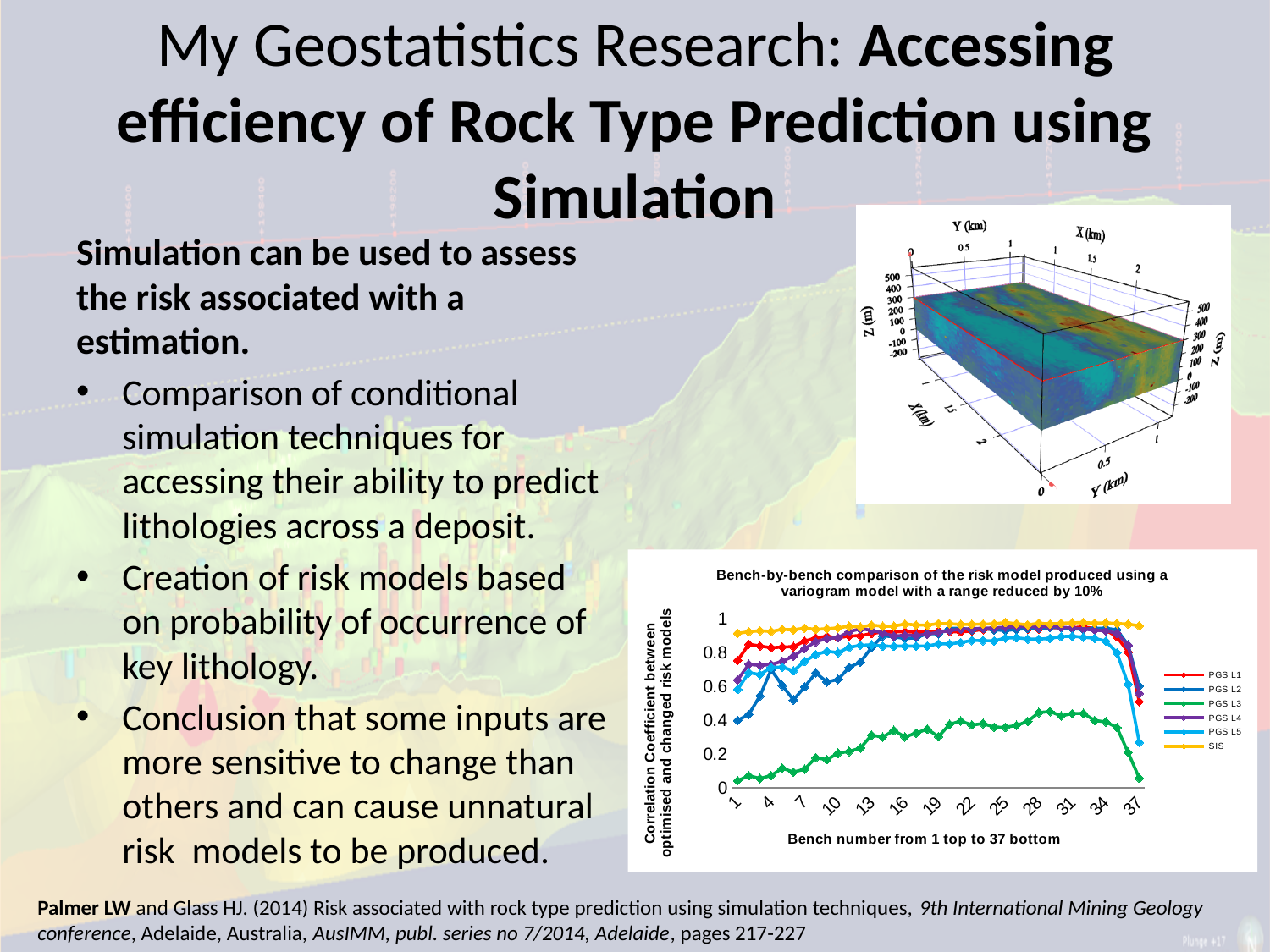
In the 'Bench-by-bench comparison' chart, is the value for PGS L3 at bench 37 greater or less than 0.2? less In the 'Bench-by-bench comparison' chart, is the value for PGS L2 at bench 1 greater or less than 0.6? less In the 'Bench-by-bench comparison' chart, is the value for SIS at bench 1 greater or less than 0.8? greater What kind of chart is the 'Bench-by-bench comparison' chart on the slide? line chart In the 'Bench-by-bench comparison' chart, which series has the lowest correlation coefficient across the benches? PGS L3 In the 'Bench-by-bench comparison' chart, what colour is the SIS series? yellow In the 'Bench-by-bench comparison' chart, which series has the highest correlation coefficient across the benches? SIS In the 'Bench-by-bench comparison' chart, which is larger at bench 1: the value for SIS or the value for PGS L3? SIS In the 'Bench-by-bench comparison' chart, does the PGS L3 series rise or fall from bench 1 to bench 28? rise What is the x-axis title of the 'Bench-by-bench comparison' chart? Bench number from 1 top to 37 bottom How many series does the legend of the 'Bench-by-bench comparison' chart list? 6